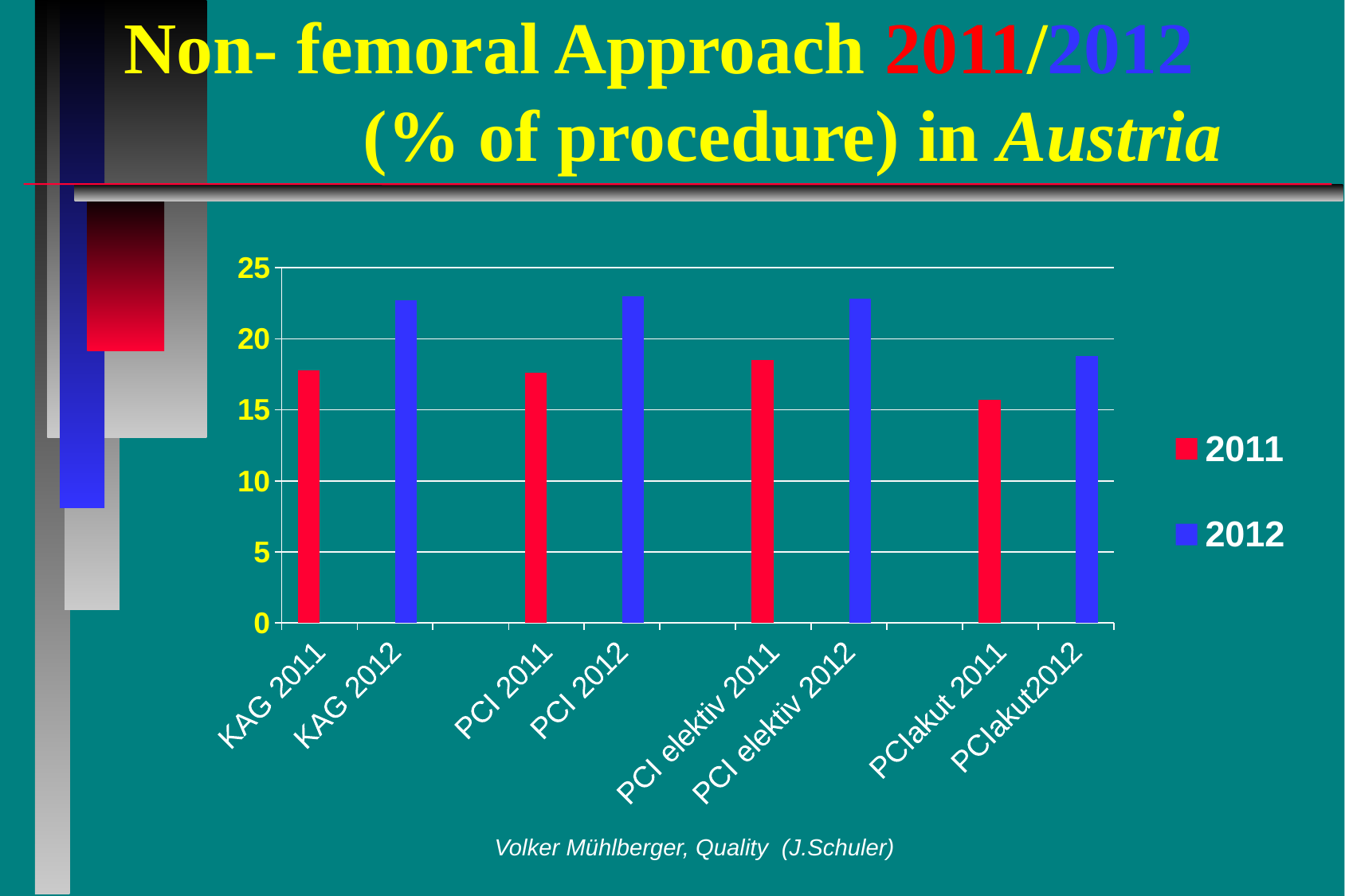
What kind of chart is shown on the slide? bar chart Which is larger, the value for PCI elektiv 2011 or PCI elektiv 2012? PCI elektiv 2012 Is the value for KAG 2011 greater or less than 20? less How many bars (categories) are plotted on the x axis? 8 Which two series are listed in the legend? 2011 and 2012 Is the value for PCIakut2012 greater or less than 20? less Which category has the lowest value? PCIakut 2011 What colour are the 2012 bars? blue How many series does the legend list? 2 Is the value for KAG 2012 greater or less than 20? greater Which is larger, the value for PCI 2011 or PCI 2012? PCI 2012